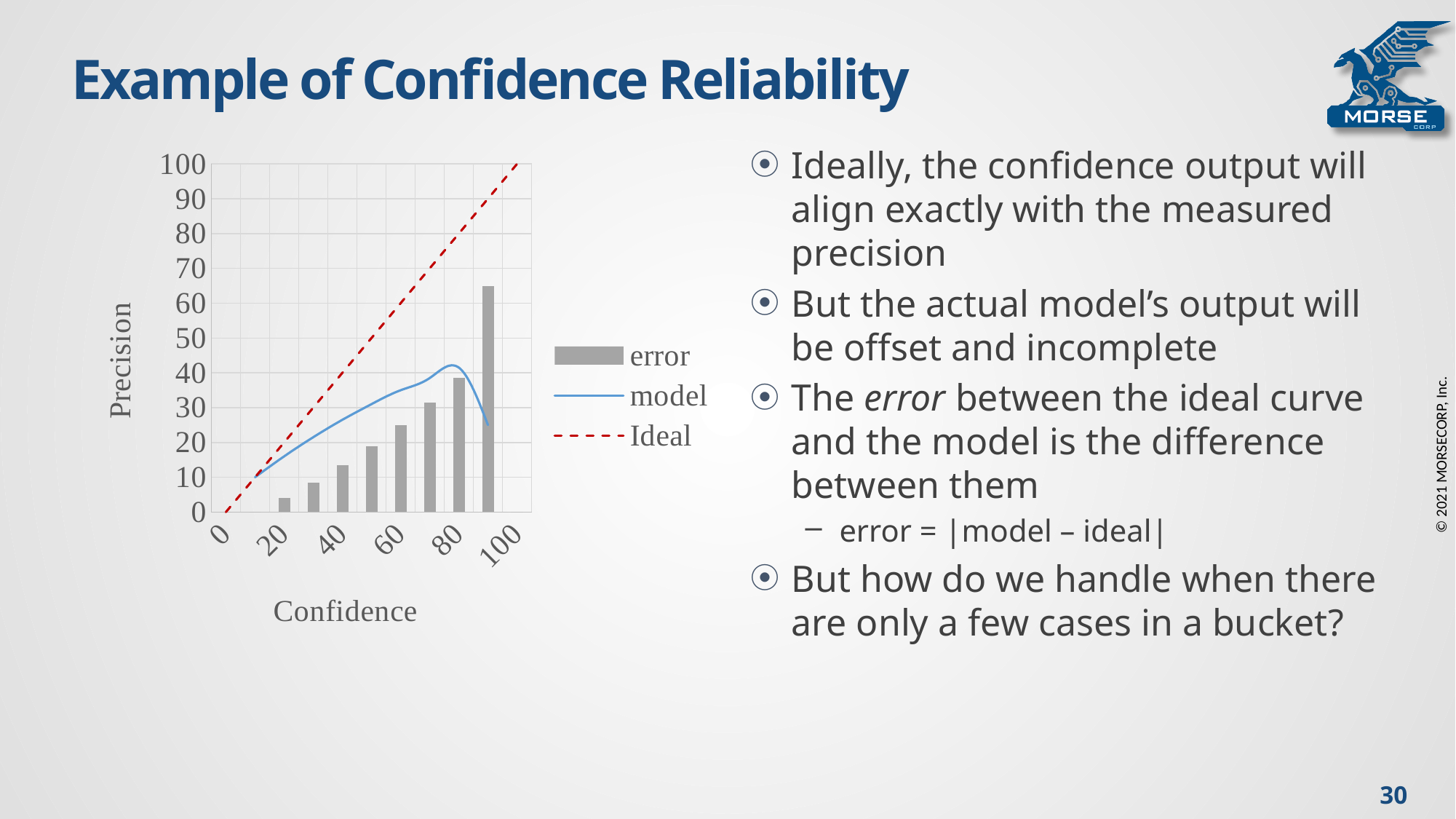
Do the error bars rise or fall as confidence increases along the x axis? rise Is the value of the tallest error bar greater or less than 60? greater What is the label of the chart's y axis? Precision What precision value does the Ideal line reach at confidence 100? 100 How many series does the chart legend list? 3 Is the value of the leftmost error bar greater or less than 10? less What are the three series named in the chart legend? error, model, Ideal Is the peak of the model line greater or less than 50? less Which error bar is the tallest: the leftmost or the rightmost? the rightmost How many error bars are plotted in the chart? 8 What kind of chart is shown on the slide? Combined bar and line chart